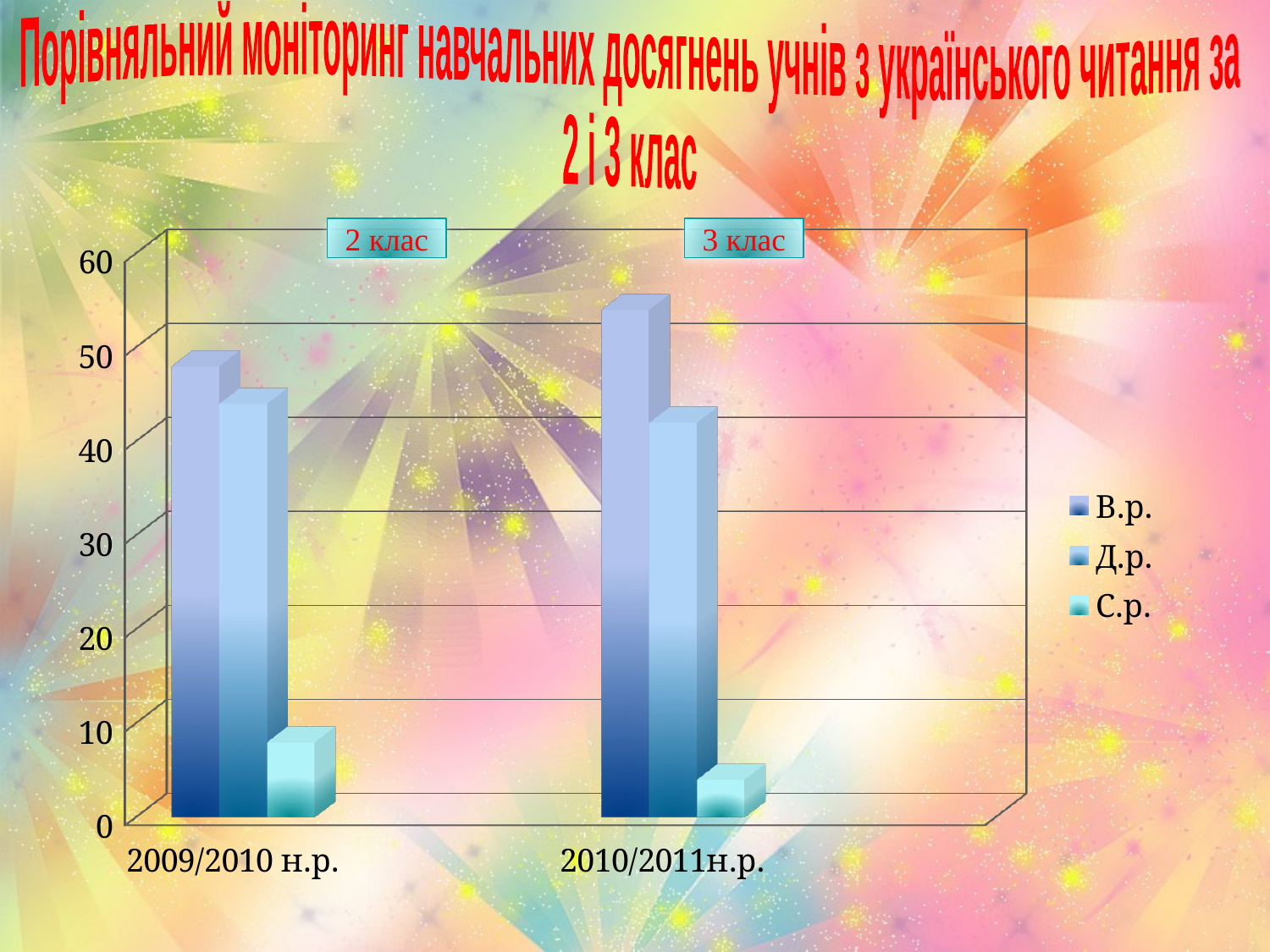
Does the value for С.р. rise or fall from 2009/2010 н.р. to 2010/2011н.р.? fall Which series has the lowest bar in 2009/2010 н.р.? С.р. Is the value for С.р. in 2010/2011н.р. greater or less than 10? less Is the value for Д.р. in 2010/2011н.р. greater or less than 50? less Which class label is shown above the 2010/2011н.р. bars? 3 клас What kind of chart is shown on the slide? bar chart Which legend entry is shown in light cyan? С.р. How many categories are shown on the x axis? 2 Which series has the highest bar in 2010/2011н.р.? В.р. Is the value for В.р. in 2010/2011н.р. greater or less than 50? greater Which is larger: В.р. in 2009/2010 н.р. or В.р. in 2010/2011н.р.? В.р. in 2010/2011н.р. How many series does the legend list? 3